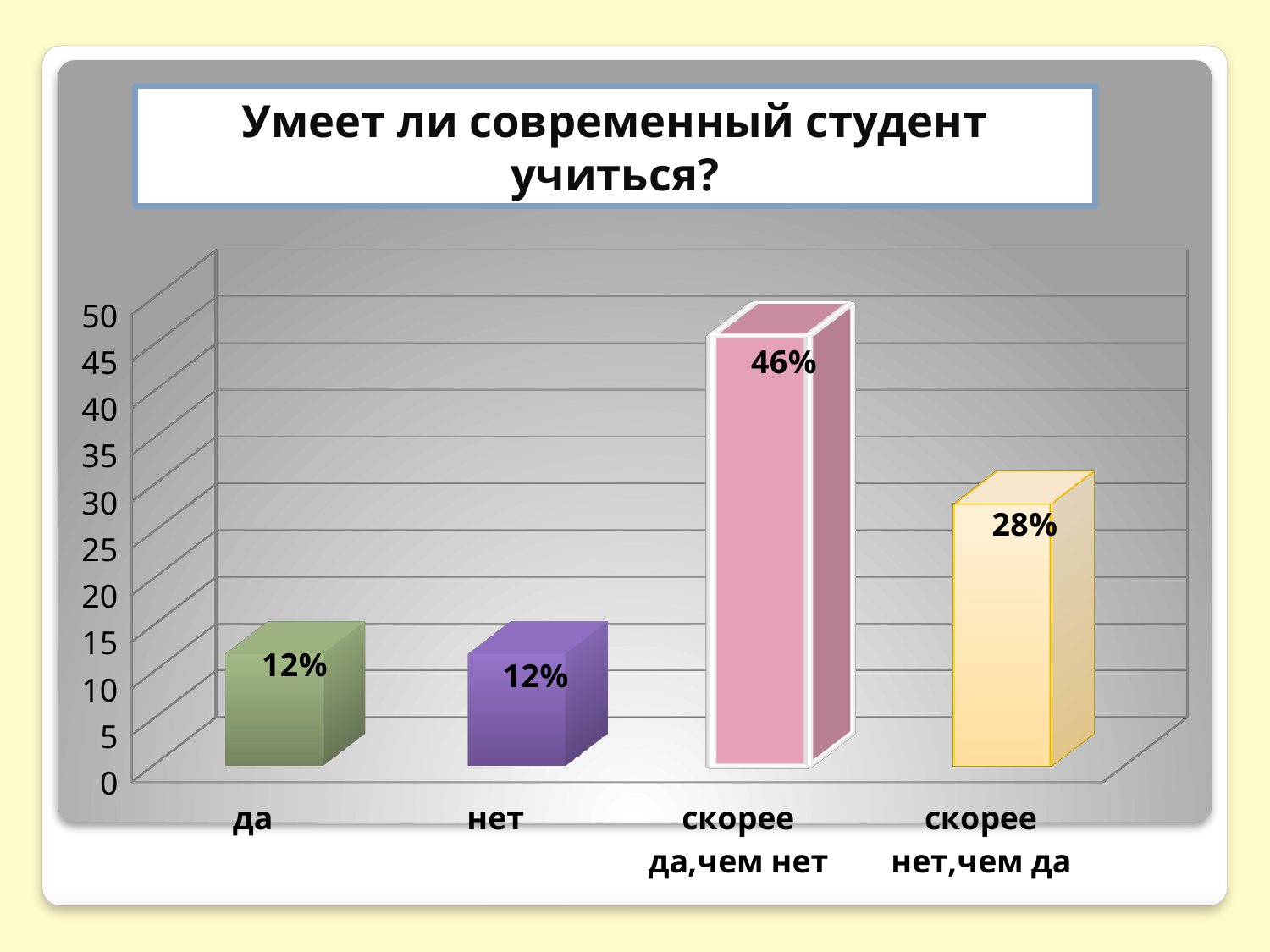
What is the value for "да"? 12% How many categories are shown on the x axis? 4 What is the difference between the values for "скорее нет,чем да" and "да"? 16% What is the value for "нет"? 12% What is the value for "скорее нет,чем да"? 28% What is the value for "скорее да,чем нет"? 46% What is the difference between the values for "скорее да,чем нет" and "скорее нет,чем да"? 18% Which is larger, the value for "скорее нет,чем да" or the value for "нет"? скорее нет,чем да What is the title of the chart? Умеет ли современный студент учиться? Is the value for "скорее да,чем нет" greater or less than 40? greater What kind of chart is shown on the slide? bar chart Which category has the highest value? скорее да,чем нет